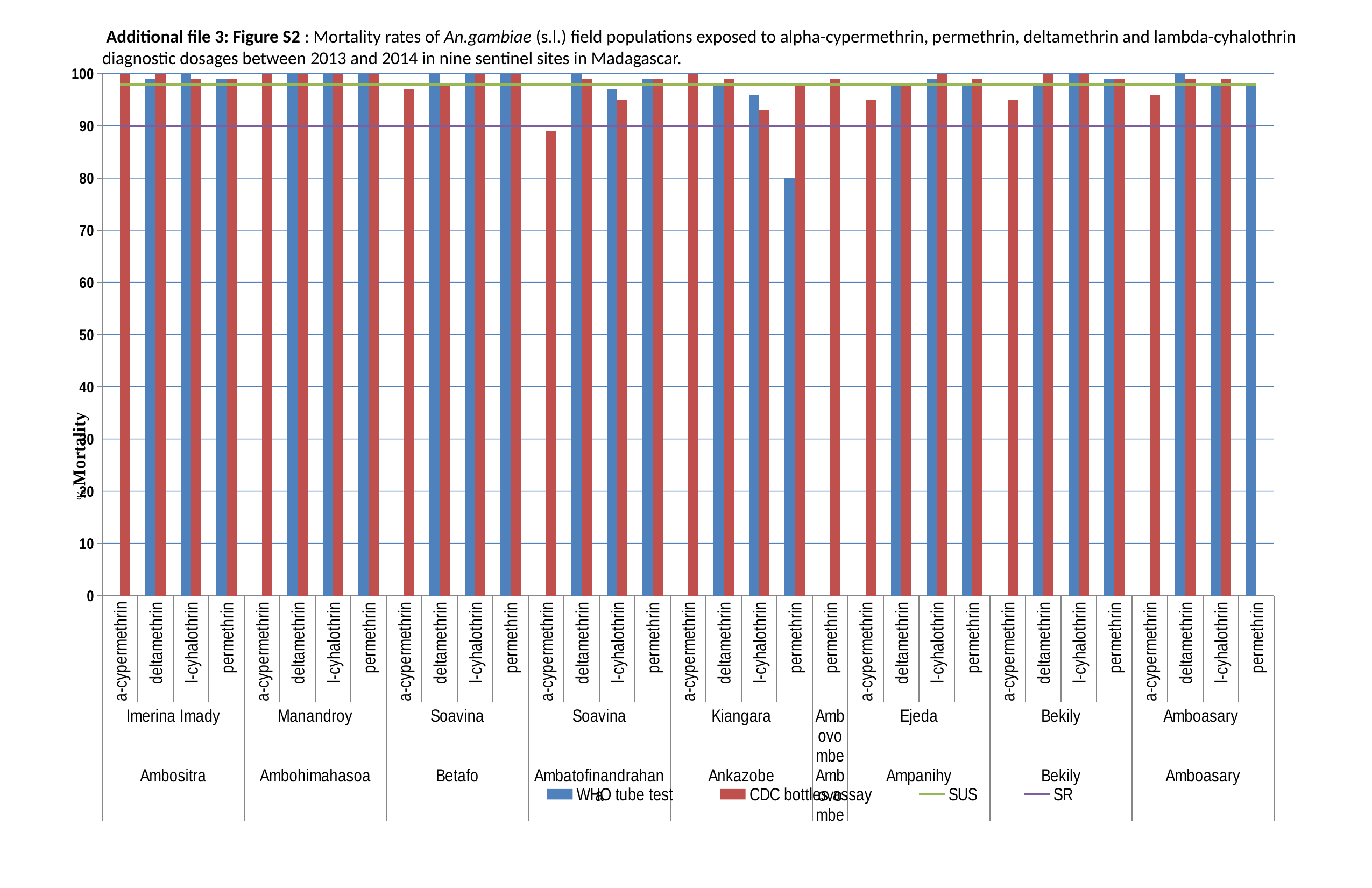
What is the label on the vertical axis? % Mortality For permethrin at Kiangara, which is larger: the WHO tube test value or the CDC bottle assay value? CDC bottle assay What kind of chart is shown on the slide? combination bar and line chart What is the WHO tube test mortality for permethrin at Manandroy (Ambohimahasoa)? 100 How many insecticides are listed for the Imerina Imady site? 4 How many series does the legend list? 4 What is the difference between the WHO tube test permethrin values at Manandroy and at Kiangara? 20 Is the CDC bottle assay value for l-cyhalothrin at Kiangara greater or less than 90? greater Which series is shown in blue in the legend? WHO tube test What is the WHO tube test mortality for permethrin at Kiangara (Ankazobe)? 80 Is the CDC bottle assay value for a-cypermethrin at Bekily greater or less than 90? greater Which bar in the chart is the lowest? WHO tube test, permethrin at Kiangara